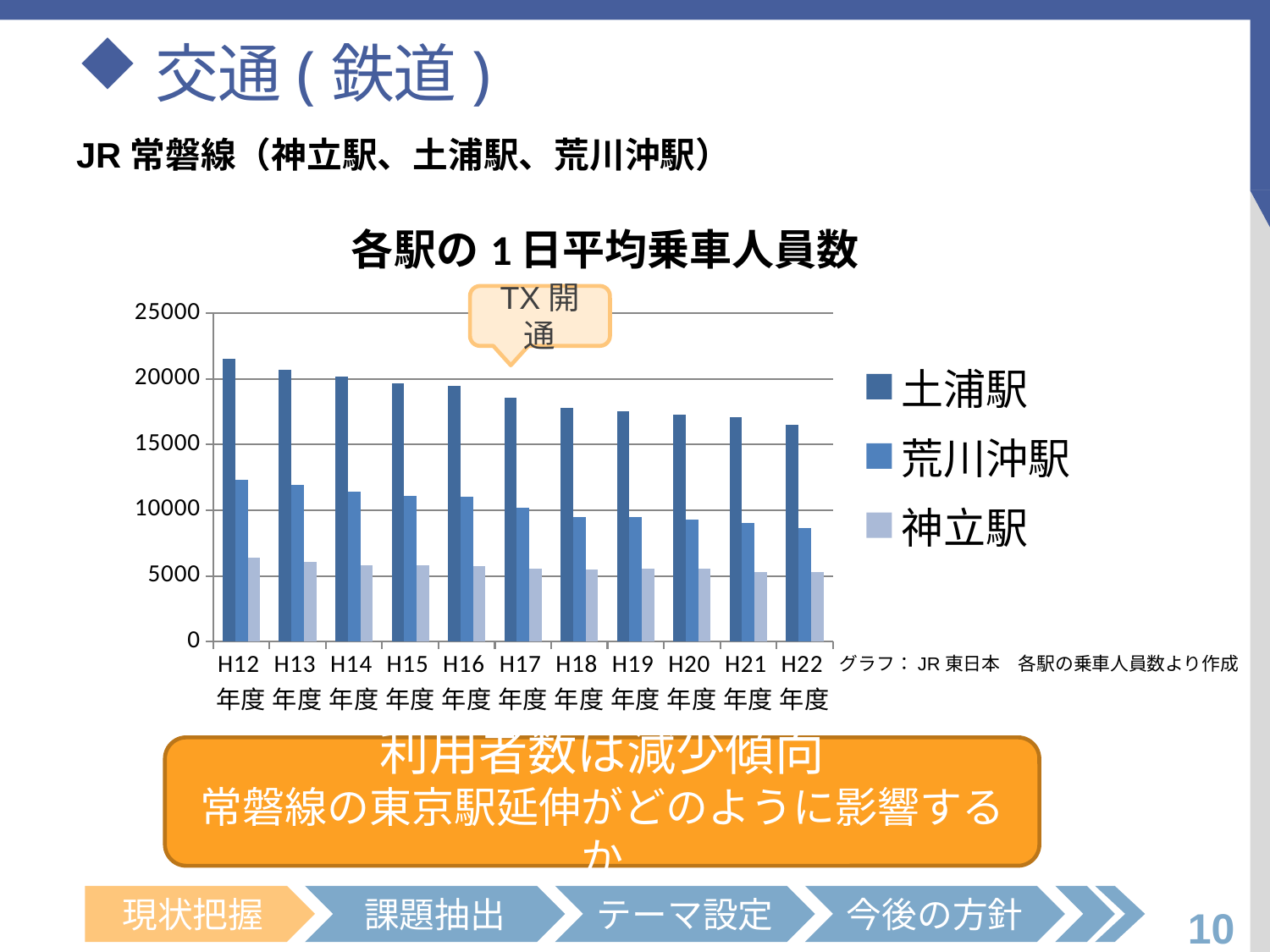
Which is larger in H15年度, the value for 荒川沖駅 or the value for 神立駅? 荒川沖駅 Is the value for 土浦駅 in H17年度 greater or less than 20000? less Is the value for 土浦駅 in H12年度 greater or less than 20000? greater Which station has the highest value in H12年度? 土浦駅 In which fiscal year is the value for 土浦駅 highest? H12年度 What is the title of the chart? 各駅の1日平均乗車人員数 What kind of chart is shown on the slide? bar chart How many fiscal years (categories) are shown on the x axis? 11 Do the values for 土浦駅 rise or fall from H12年度 to H22年度? fall In which fiscal year is the value for 荒川沖駅 lowest? H22年度 Is the value for 荒川沖駅 in H22年度 greater or less than 10000? less How many series does the chart's legend list? 3